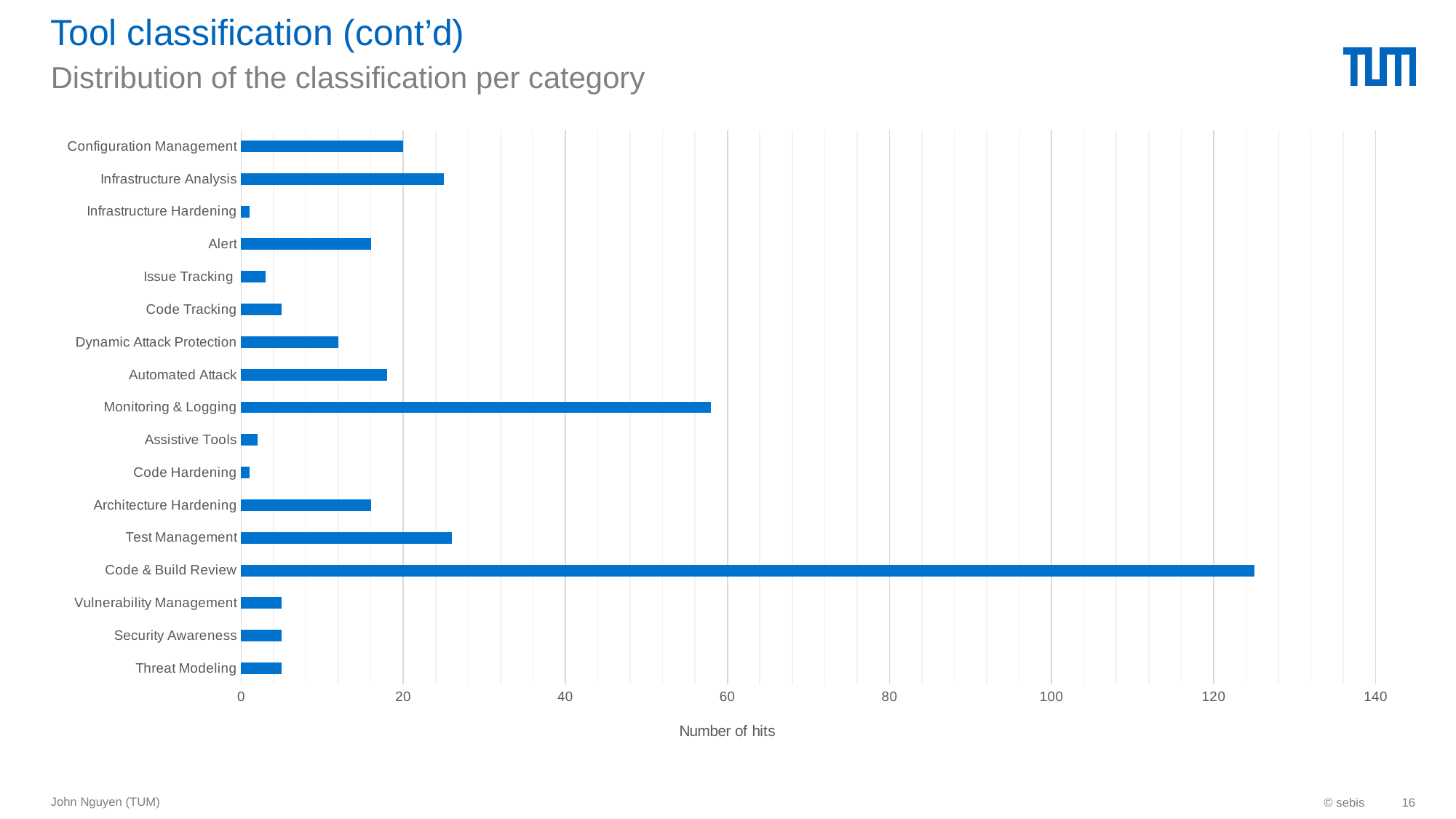
Is the value for Monitoring & Logging greater or less than 60? less Which has more hits, Automated Attack or Dynamic Attack Protection? Automated Attack Which has more hits, Monitoring & Logging or Test Management? Monitoring & Logging What is the subtitle of the slide describing the chart? Distribution of the classification per category Is the value for Alert greater or less than 20? less Is the value for Infrastructure Analysis greater or less than 20? greater What kind of chart is shown on the slide? bar chart Which category has the highest number of hits? Code & Build Review What is the label of the horizontal axis? Number of hits How many categories are shown on the chart? 17